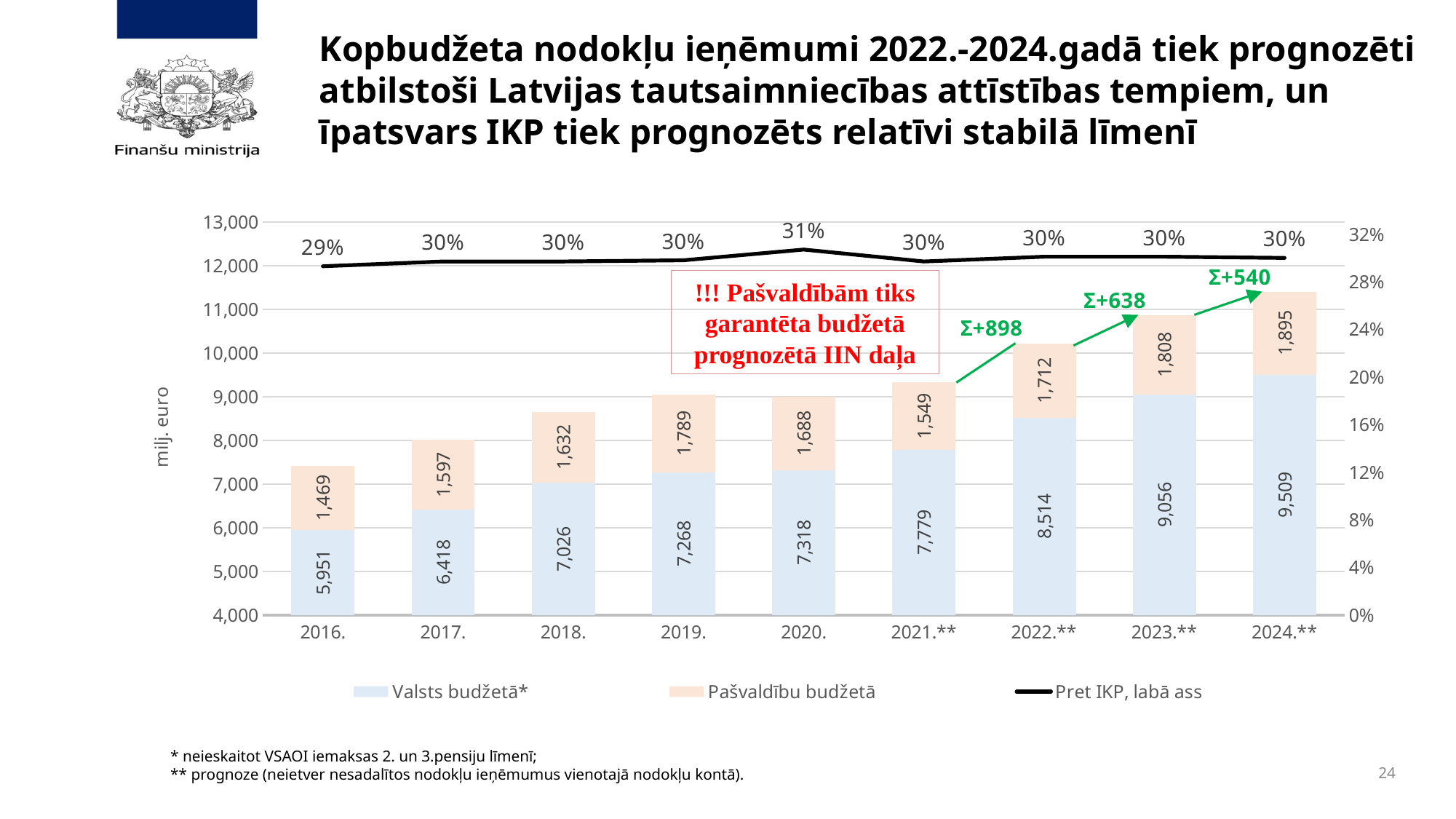
How many series does the legend list? 3 Which year has the lowest Pašvaldību budžetā value? 2016. What is the value for Valsts budžetā* in 2024.**? 9,509 Is the total stacked bar for 2018. greater or less than 9,000? less What is the value for Pašvaldību budžetā in 2019.? 1,789 How many years are shown on the x axis? 9 Which year has the highest Valsts budžetā* value? 2024.** What is the total of the stacked bar for 2016.? 7,420 Does the Valsts budžetā* series rise or fall from 2016. to 2024.**? rise Which is larger, the Pašvaldību budžetā value for 2020. or for 2021.**? 2020. What is the difference between the Valsts budžetā* values for 2022.** and 2021.**? 735 What is the Pret IKP, labā ass value for 2020.? 31%